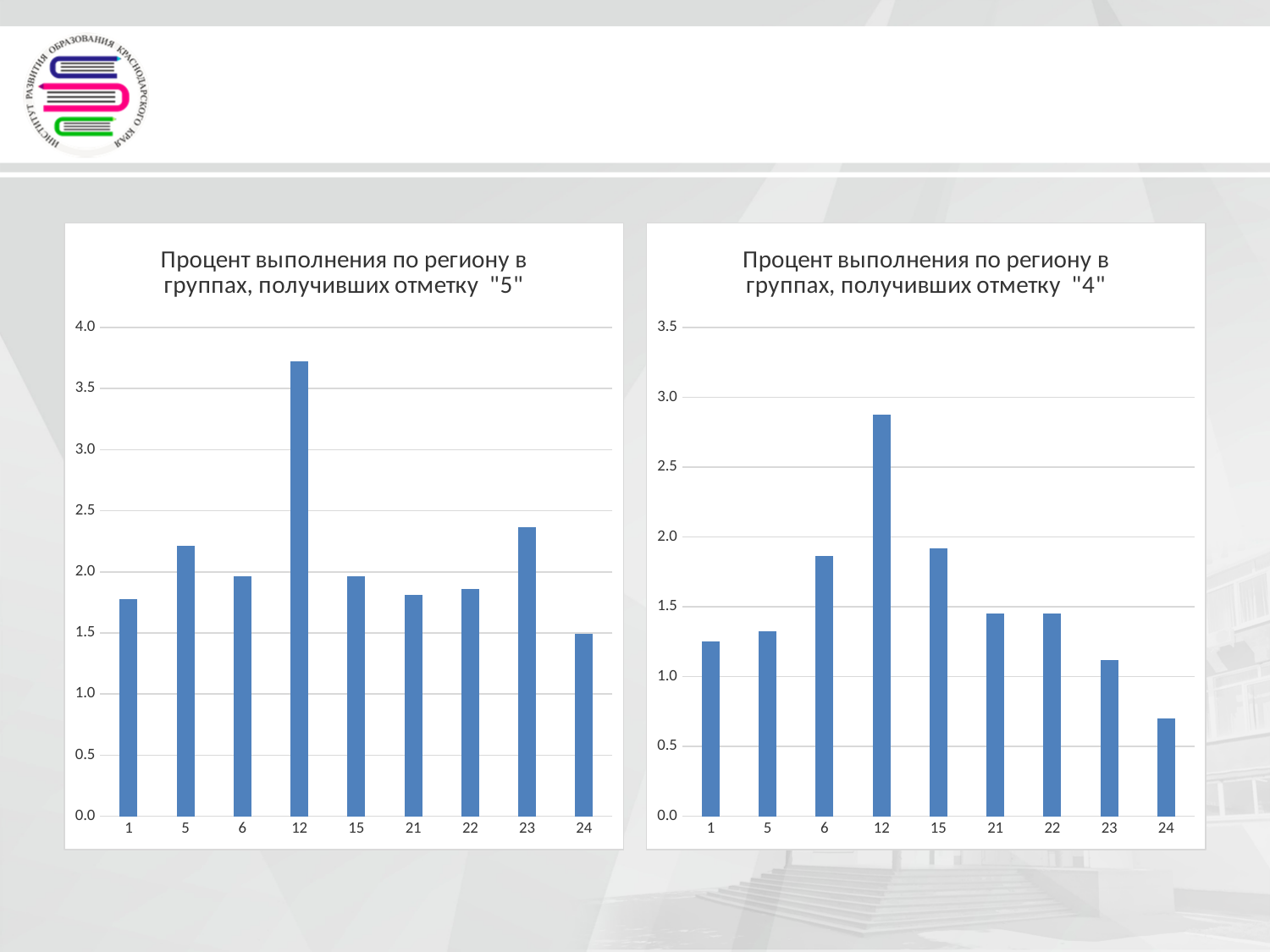
In the right chart (отметка "4"), which is larger, the value for category 23 or category 24? 23 In the left chart (отметка "5"), is the value for category 24 greater or less than 2.0? less In the right chart (отметка "4"), which category has the highest value? 12 In the right chart (отметка "4"), is the value for category 24 greater or less than 1.0? less What kind of chart is the chart titled 'Процент выполнения по региону в группах, получивших отметку "5"'? bar chart In the right chart (отметка "4"), is the value for category 6 greater or less than 1.5? greater How many categories are shown on the x axis of the left chart (отметка "5")? 9 In the left chart (отметка "5"), which category has the lowest value? 24 In the right chart (отметка "4"), which category has the lowest value? 24 In the left chart (отметка "5"), which category has the highest value? 12 In the left chart (отметка "5"), which is larger, the value for category 5 or category 1? 5